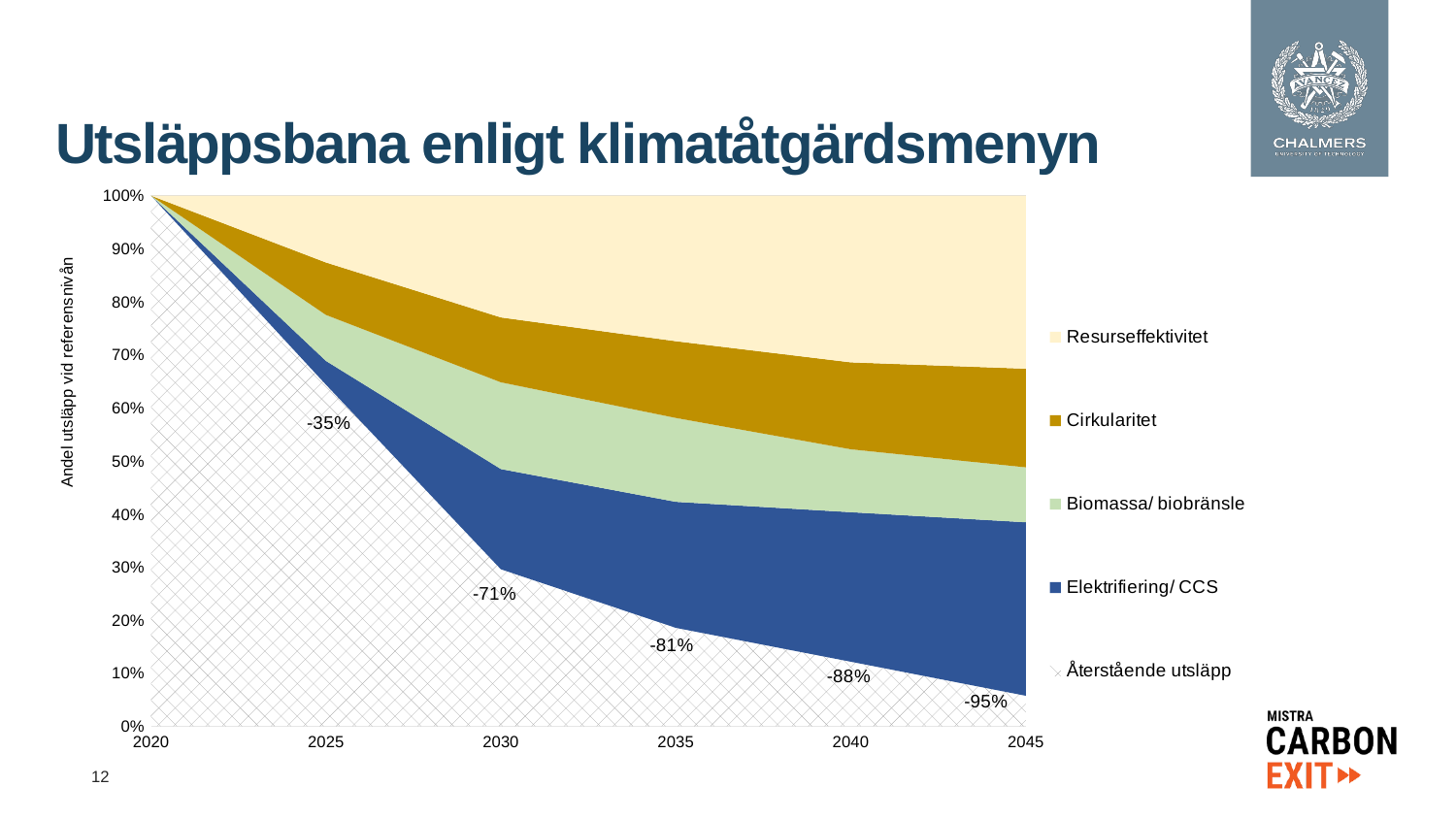
Does the Återstående utsläpp area rise or fall from 2020 to 2045? Fall What reduction label is shown at 2045? -95% How many years are marked on the x axis? 6 What reduction label is shown at 2030? -71% What kind of chart is shown on the slide? Stacked area chart How many series does the legend list? 5 What is the title of the y axis? Andel utsläpp vid referensnivån By how many percentage points does the labelled reduction differ between 2025 (-35%) and 2045 (-95%)? 60 percentage points Which year has the largest labelled reduction? 2045 What reduction label is shown at 2025? -35% Is the top of the Återstående utsläpp area at 2030 greater or less than 40%? less What reduction label is shown at 2035? -81%